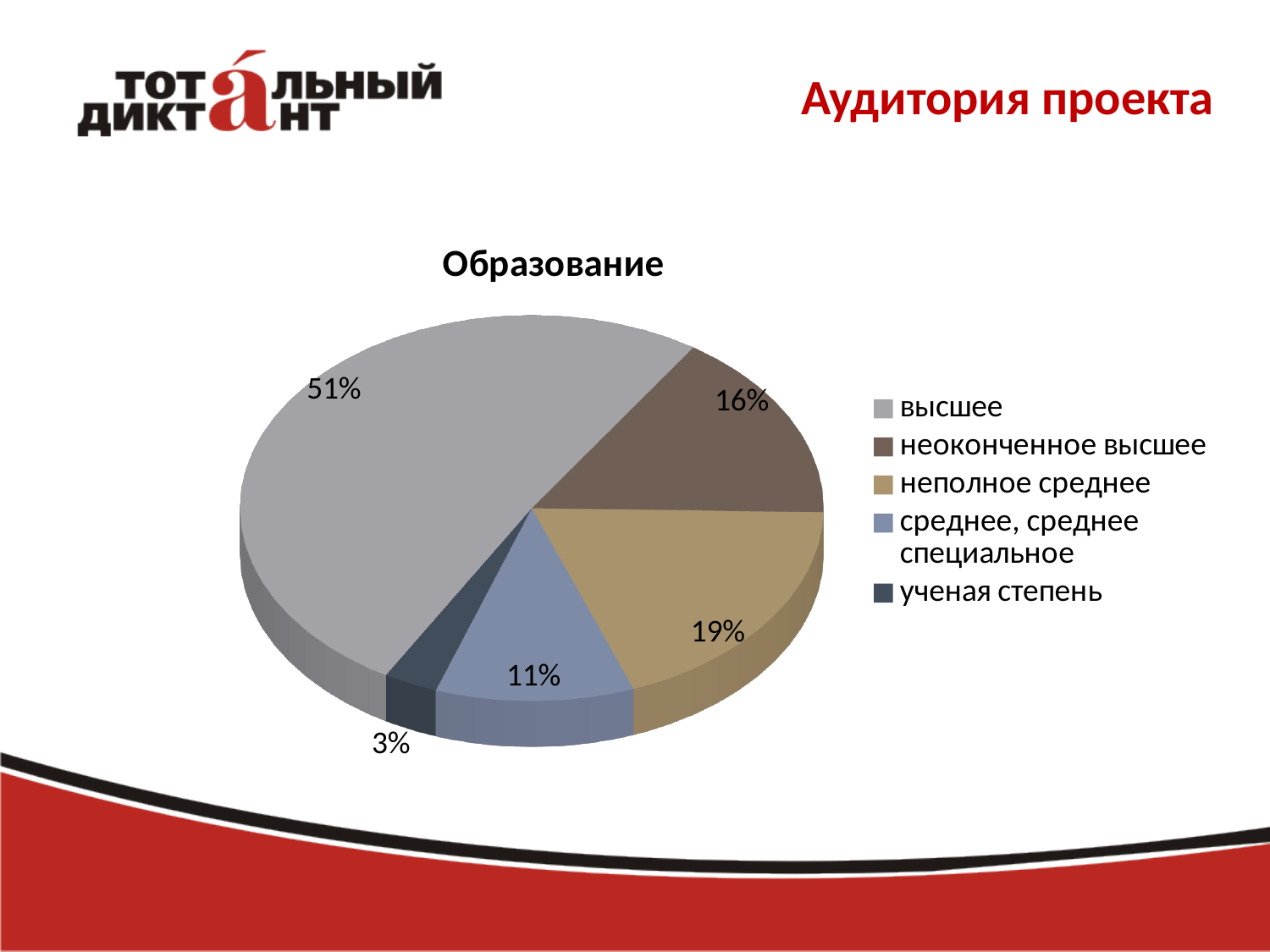
What is the difference between the shares of "неполное среднее" and "неоконченное высшее"? 3% How many categories does the pie chart show? 5 What share of the pie does "неоконченное высшее" have? 16% What share of the pie does "высшее" have? 51% What is the title of the chart? Образование Which is larger: the share of "неполное среднее" or the share of "среднее, среднее специальное"? неполное среднее What share of the pie does "ученая степень" have? 3% What share of the pie does "неполное среднее" have? 19% Which category has the smallest slice of the pie? ученая степень What share of the pie does "среднее, среднее специальное" have? 11% What kind of chart is shown on the slide? pie chart Which category has the largest slice of the pie? высшее